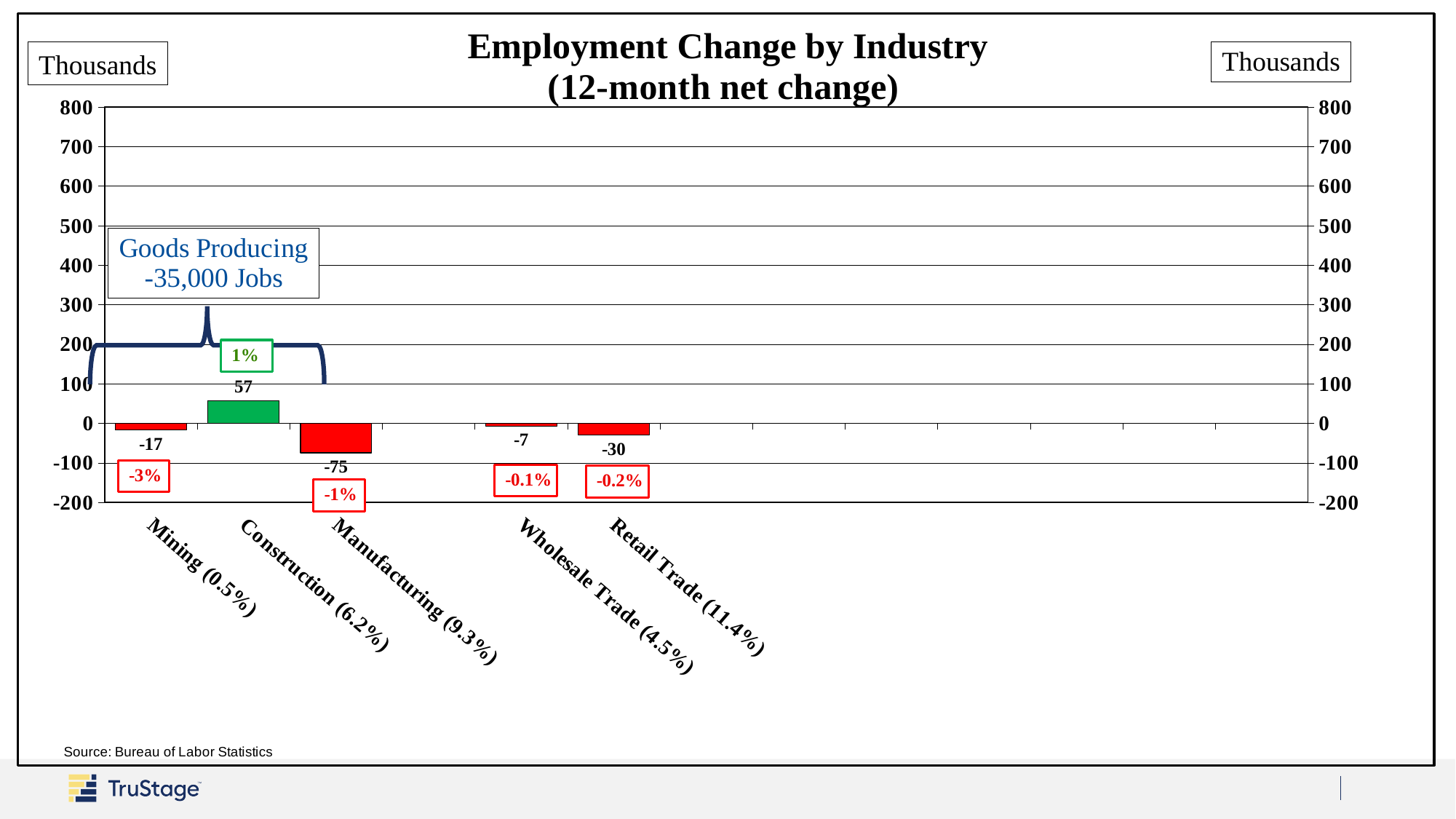
How many industries are labeled on the x axis? 5 What is the 12-month net employment change for Construction? 57 What is the 12-month net employment change for Retail Trade? -30 Which has a larger employment change, Retail Trade or Wholesale Trade? Wholesale Trade What kind of chart is shown on the slide? Bar chart According to the callout box, how many jobs did the Goods Producing sector lose? -35,000 Jobs What is the 12-month net employment change for Manufacturing? -75 Is the value for Manufacturing greater or less than -100? greater What is the difference between the employment change for Construction and Mining? 74 Which industry has the highest 12-month net employment change? Construction Which industry has the lowest 12-month net employment change? Manufacturing What is the 12-month net employment change for Wholesale Trade? -7